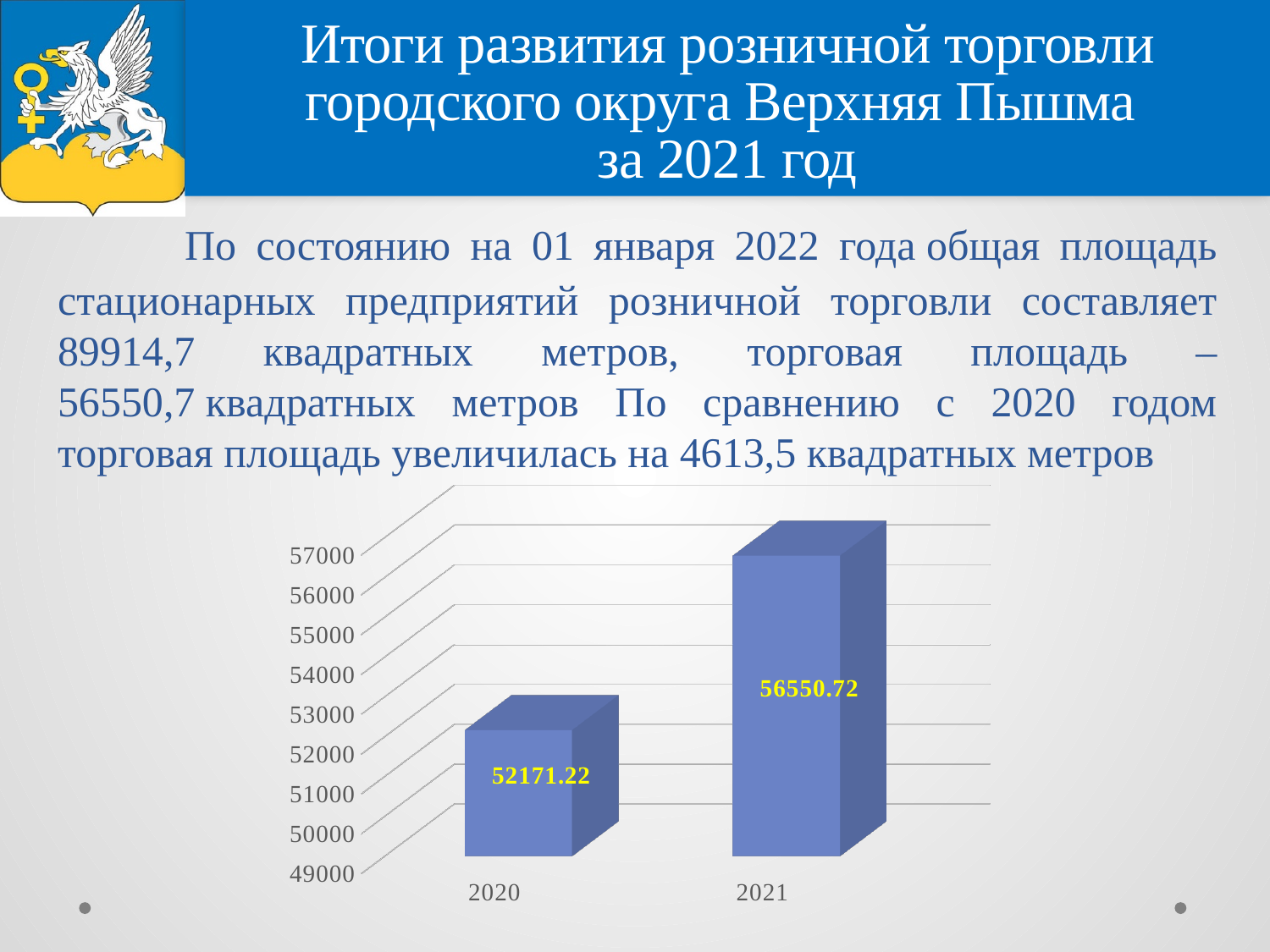
How many bars are shown in the chart? 2 Is the value for 2020 greater or less than 53000? less What is the value shown for 2021? 56550.72 What is the difference between the values for 2021 and 2020? 4379.5 What kind of chart is shown on the slide? bar chart Which is larger, the value for 2020 or the value for 2021? 2021 What is the value shown for 2020? 52171.22 Is the value for 2021 greater or less than 56000? greater Do the values rise or fall from 2020 to 2021? rise Which year has the highest value? 2021 Which year has the lowest value? 2020 What colour are the data labels on the bars? yellow